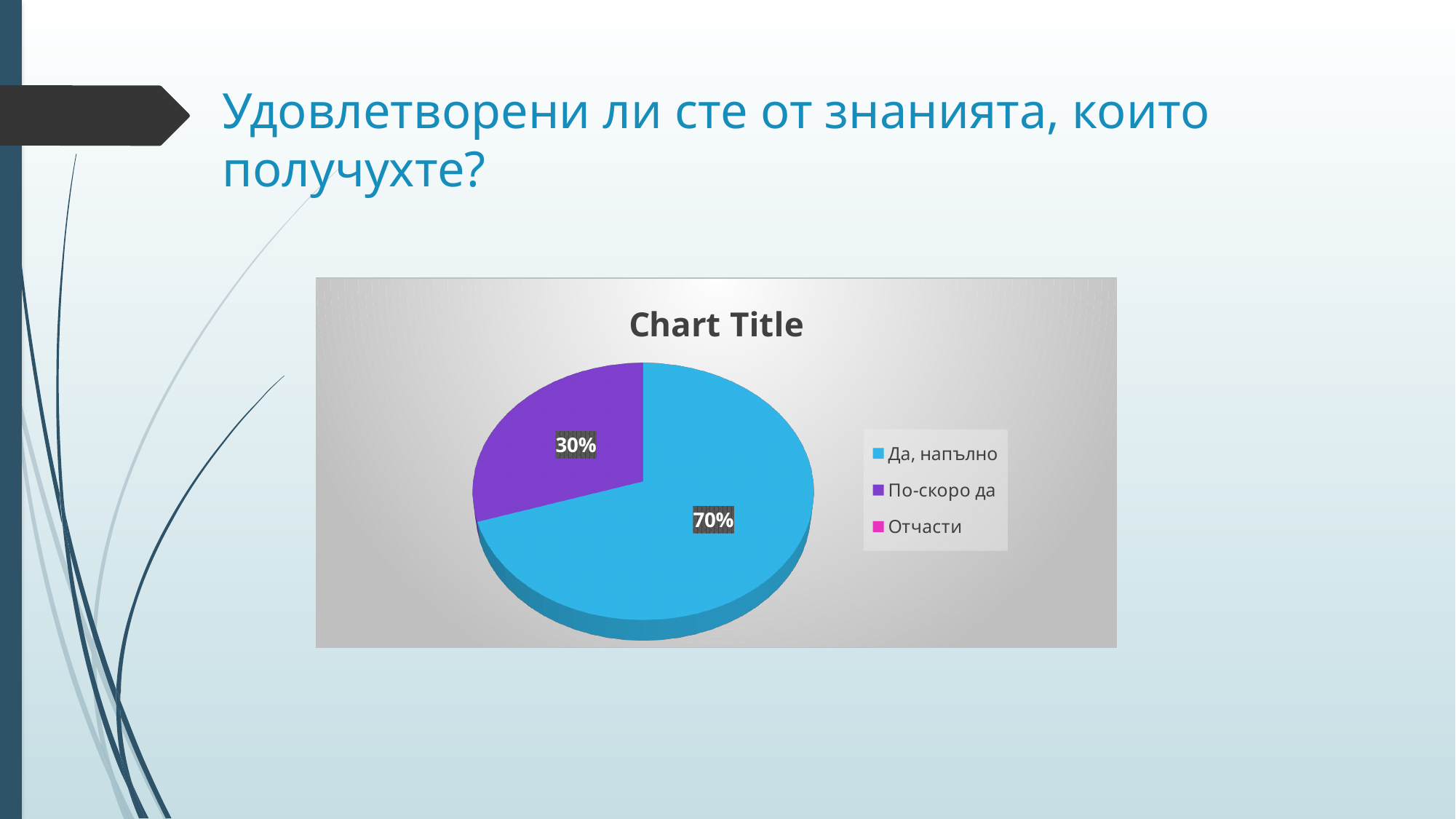
Which category has the largest slice of the pie? Да, напълно What is the difference in percentage points between the "Да, напълно" and "По-скоро да" slices? 40 percentage points What is the title shown on the chart? Chart Title What colour is the "По-скоро да" slice? purple Is the share for "Да, напълно" greater or less than 50%? greater What kind of chart is shown on the slide? pie chart What share of the pie does "Да, напълно" take? 70% Which is larger, the "Да, напълно" slice or the "По-скоро да" slice? Да, напълно How many entries does the legend list? 3 Which of the two visible slices is smaller, "Да, напълно" or "По-скоро да"? По-скоро да What share of the pie does "По-скоро да" take? 30%